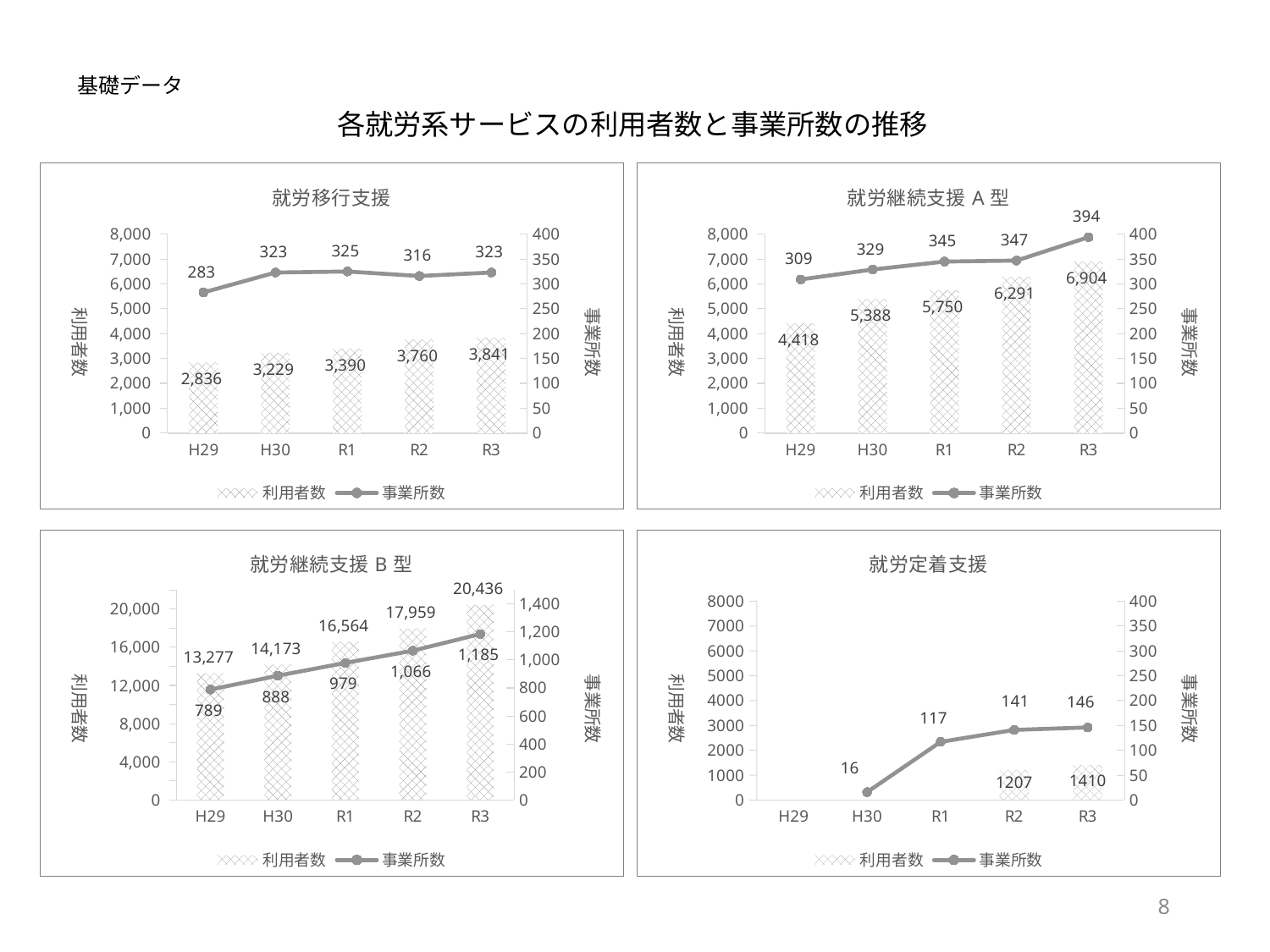
In the 就労定着支援 chart, which is larger, the 利用者数 for R2 or for R3? R3 In the 就労定着支援 chart, what is the 事業所数 value for H30? 16 In the 就労継続支援 B 型 chart, which year has the highest 事業所数 value? R3 How many year categories are shown on the x axis of the 就労継続支援 B 型 chart? 5 In the 就労継続支援 A 型 chart, does the 利用者数 rise or fall from H29 to R3? rise In the 就労移行支援 chart, what is the 利用者数 value for R3? 3,841 In the 就労継続支援 A 型 chart, what is the difference in 利用者数 between R3 and H29? 2,486 In the 就労継続支援 B 型 chart, what is the 利用者数 value for R2? 17,959 In the 就労継続支援 B 型 chart, what is the difference in 事業所数 between R3 and H29? 396 How many series does the legend of the 就労移行支援 chart list? 2 In the 就労継続支援 A 型 chart, what is the 事業所数 value for R3? 394 In the 就労移行支援 chart, which year has the lowest 事業所数 value? H29